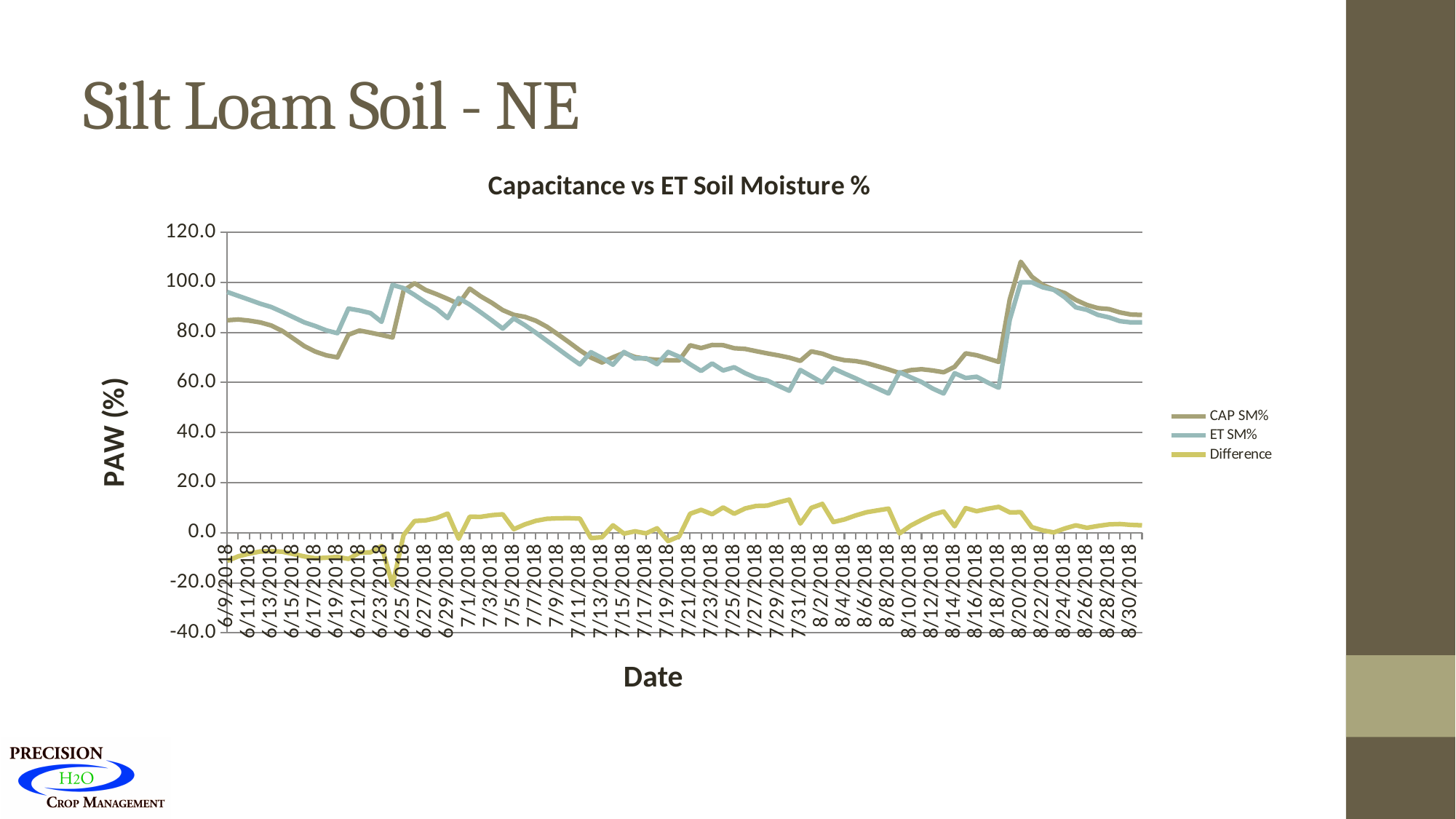
What is the label of the vertical axis? PAW (%) What kind of chart is shown on the slide? line chart Is the value of ET SM% on 8/8/2018 greater or less than 60? less What is the title of the chart? Capacitance vs ET Soil Moisture % Is the peak value of CAP SM% around 8/20/2018 greater or less than 100? greater On 6/9/2018, which series has the higher value, CAP SM% or ET SM%? ET SM% Is the value of ET SM% on 6/9/2018 greater or less than 80? greater How many series does the legend list? 3 Which series reaches the highest value anywhere on the chart? CAP SM% On 8/8/2018, which series has the higher value, CAP SM% or ET SM%? CAP SM% Does the CAP SM% series rise or fall from 8/20/2018 to 8/30/2018? fall